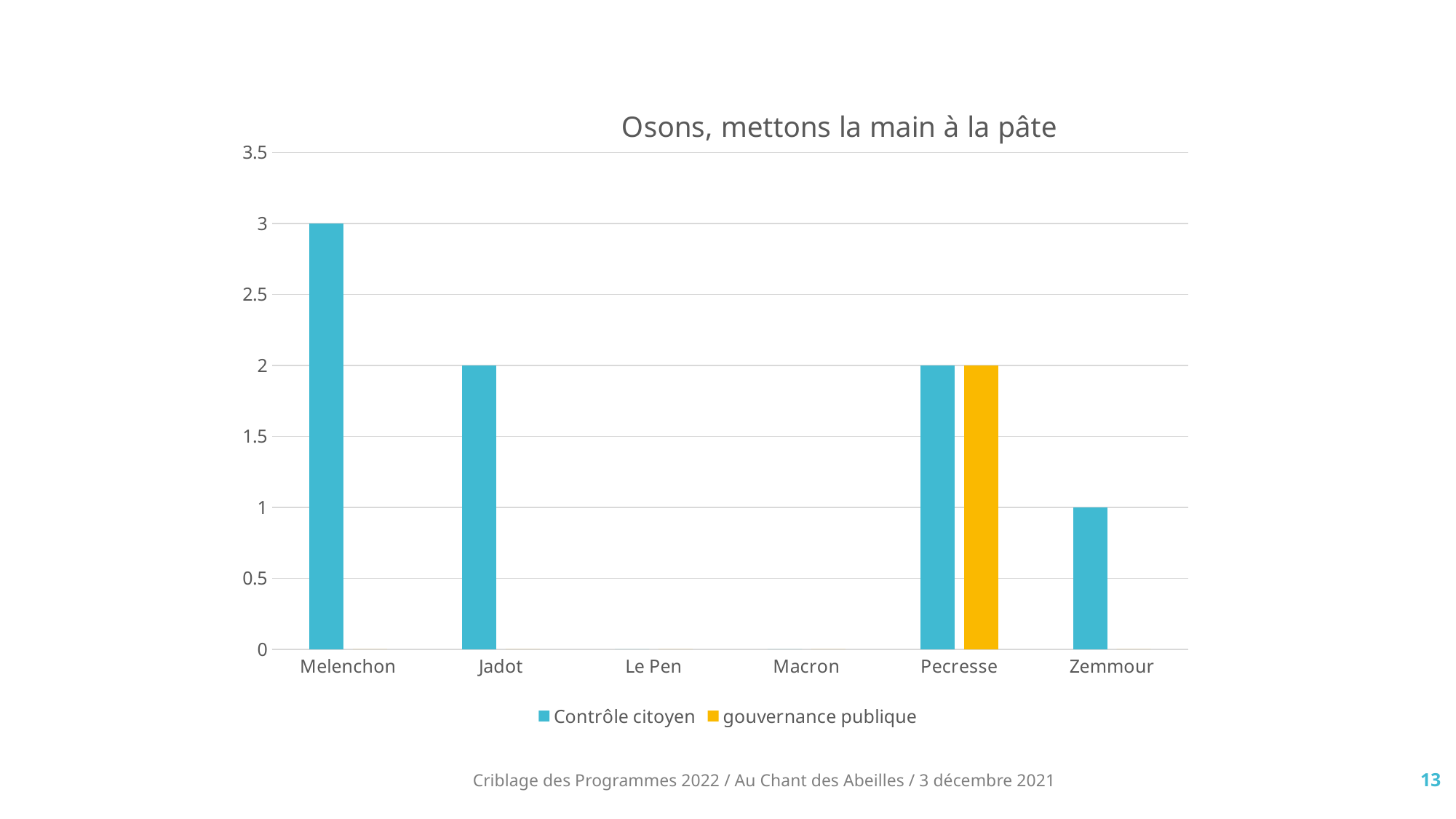
Which candidate has the highest Contrôle citoyen value? Melenchon What is the difference between the Contrôle citoyen values for Melenchon and Zemmour? 2 How many candidates are shown on the x axis? 6 What kind of chart is shown on the slide? bar chart What is the Contrôle citoyen value for Melenchon? 3 What is the gouvernance publique value for Pecresse? 2 Which is larger, the Contrôle citoyen value for Jadot or for Zemmour? Jadot What is the Contrôle citoyen value for Zemmour? 1 Which candidate is the only one with a gouvernance publique bar? Pecresse What is the title of the chart? Osons, mettons la main à la pâte What is the Contrôle citoyen value for Jadot? 2 How many series does the legend list? 2